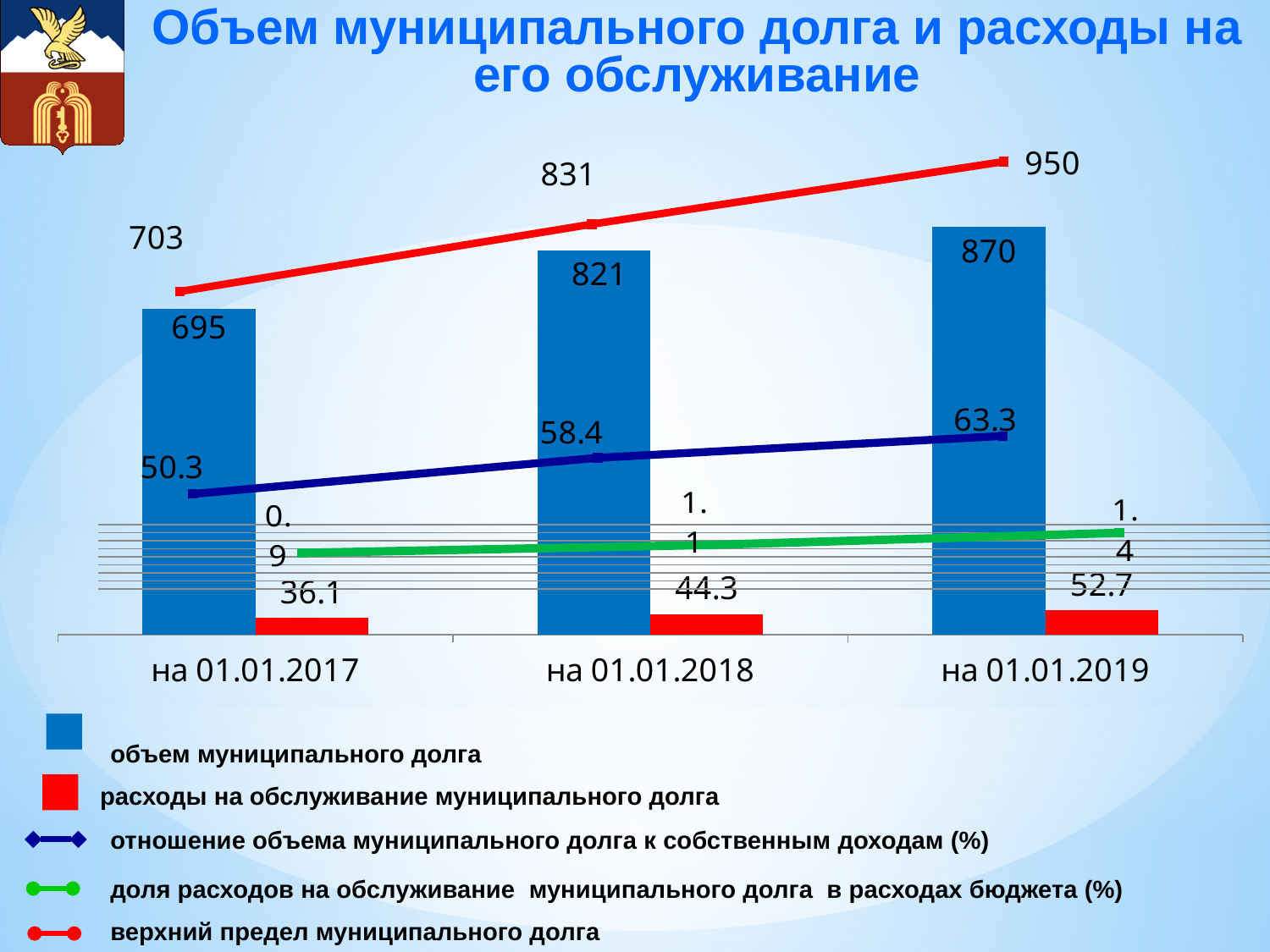
Which is larger: объем муниципального долга на 01.01.2017 or на 01.01.2018? на 01.01.2018 What is the верхний предел муниципального долга на 01.01.2017? 703 How many dates (categories) are shown on the x axis? 3 How many series does the legend list? 5 What is the отношение объема муниципального долга к собственным доходам (%) на 01.01.2018? 58.4 At which date is расходы на обслуживание муниципального долга the lowest? на 01.01.2017 Does the отношение объема муниципального долга к собственным доходам (%) rise or fall from 01.01.2017 to 01.01.2019? rise What is the value of расходы на обслуживание муниципального долга на 01.01.2019? 52.7 At which date is объем муниципального долга the highest? на 01.01.2019 What is the value of объем муниципального долга на 01.01.2018? 821 By how much did объем муниципального долга increase from 01.01.2017 to 01.01.2019? 175 What is the difference between верхний предел муниципального долга and объем муниципального долга на 01.01.2019? 80